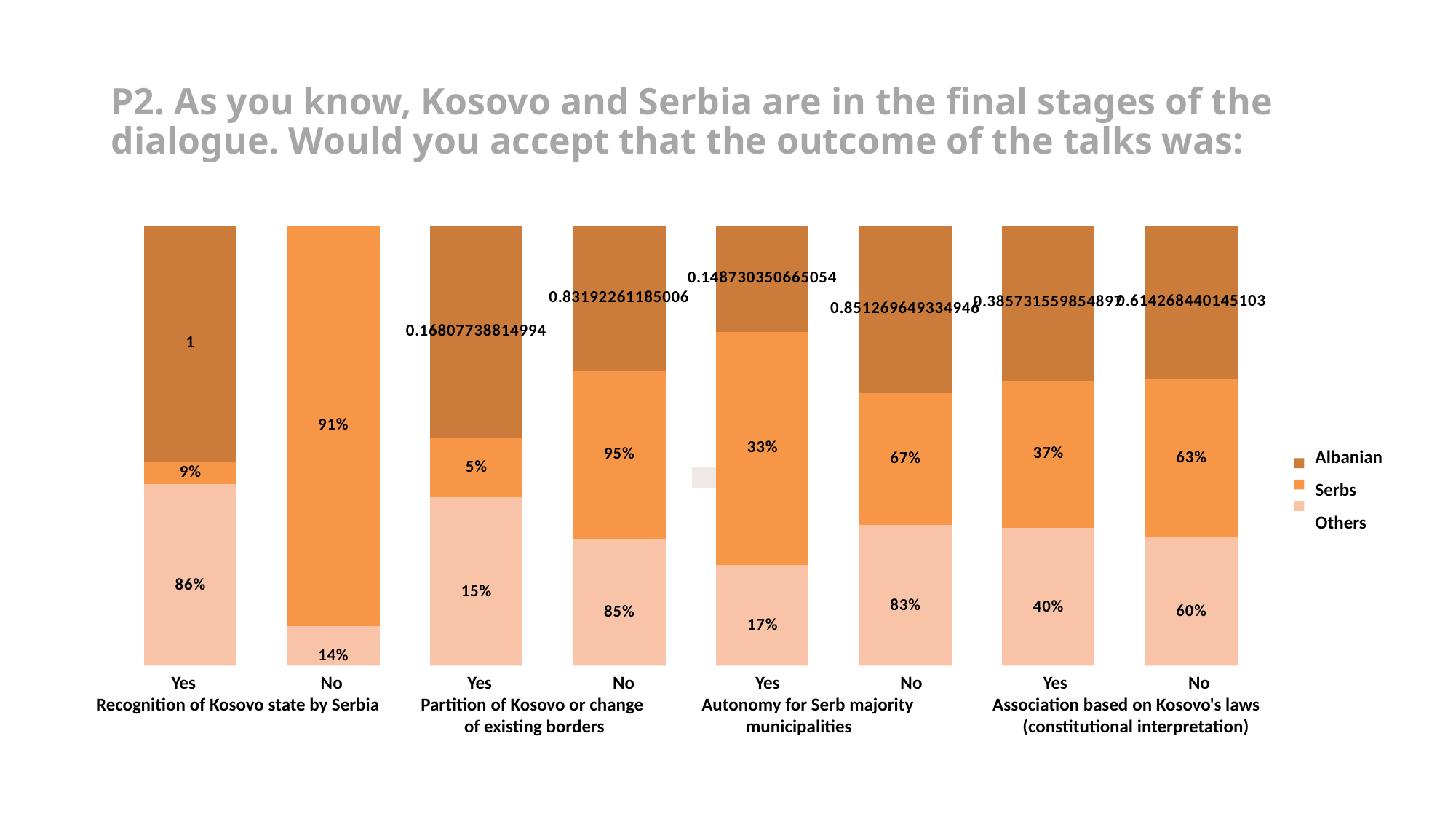
Which bar has the lowest Serbs value? Yes, Partition of Kosovo or change of existing borders What is the Serbs value for 'Yes' under 'Association based on Kosovo's laws (constitutional interpretation)'? 37% Which series are listed in the legend? Albanian, Serbs, Others What is the Serbs value for 'No' under 'Recognition of Kosovo state by Serbia'? 91% What is the Serbs value for 'No' under 'Partition of Kosovo or change of existing borders'? 95% What is the difference between the Others values for 'No' and 'Yes' under 'Association based on Kosovo's laws (constitutional interpretation)'? 20% Which 'Yes' bar has the highest Serbs value? Yes, Association based on Kosovo's laws (constitutional interpretation) What type of chart is shown on the slide? stacked bar chart How many series does the legend list? 3 How many bars are plotted in the chart? 8 What is the Others value for 'Yes' under 'Autonomy for Serb majority municipalities'? 17% What is the Others value for 'Yes' under 'Recognition of Kosovo state by Serbia'? 86%